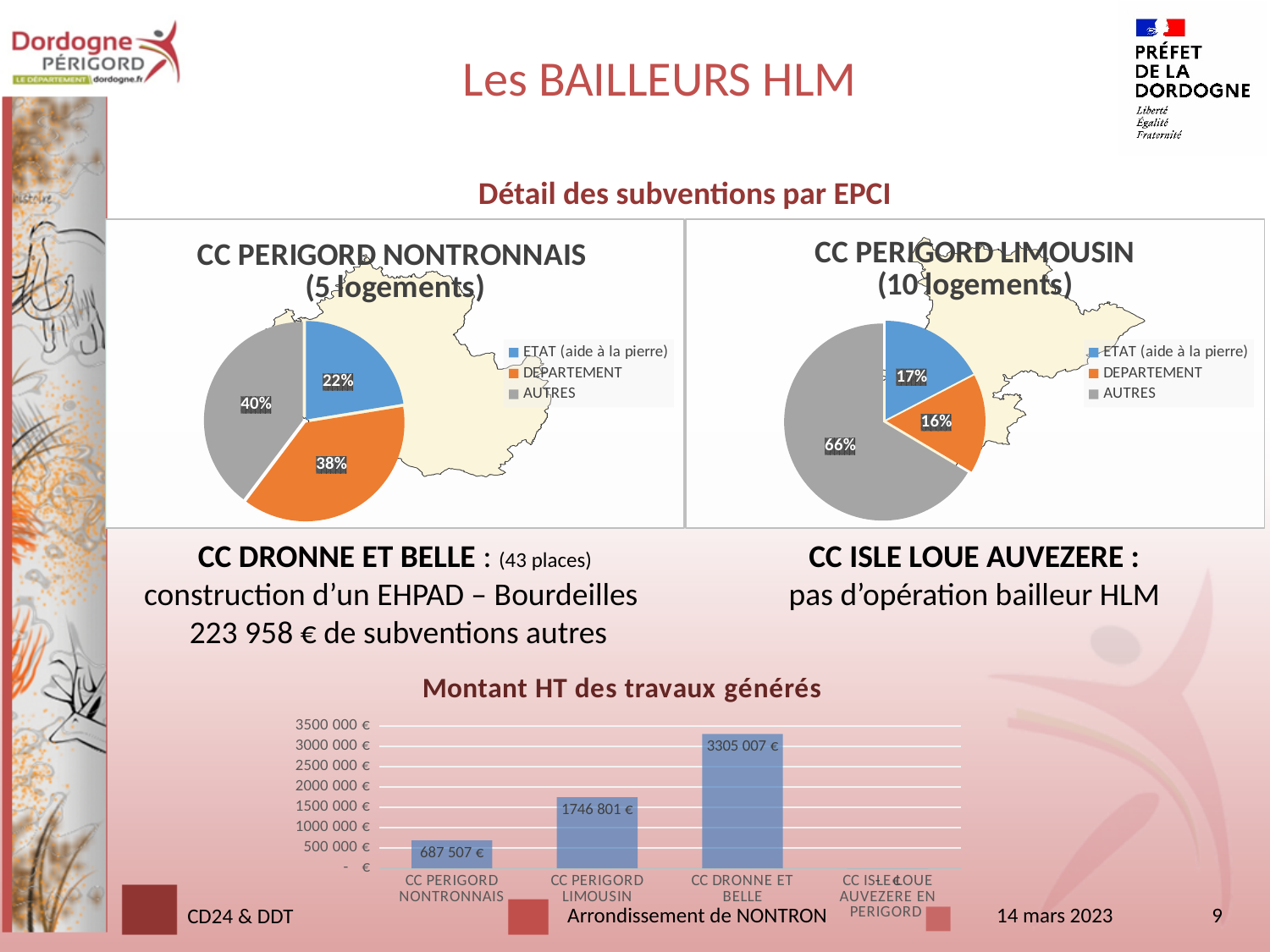
In the CC PERIGORD LIMOUSIN pie chart, what is the difference in percentage points between AUTRES and ETAT (aide à la pierre)? 49 percentage points In the CC PERIGORD LIMOUSIN pie chart, which slice is the smallest? DEPARTEMENT In the 'Montant HT des travaux générés' chart, what is the difference between CC PERIGORD LIMOUSIN and CC PERIGORD NONTRONNAIS? 1059 294 € In the CC PERIGORD NONTRONNAIS pie chart, which slice is the largest? AUTRES In the 'Montant HT des travaux générés' chart, what is the value for CC DRONNE ET BELLE? 3305 007 € In the CC PERIGORD NONTRONNAIS pie chart, what is the share for ETAT (aide à la pierre)? 22% In the 'Montant HT des travaux générés' chart, what is the value for CC PERIGORD NONTRONNAIS? 687 507 € In the 'Montant HT des travaux générés' chart, which category has the highest value? CC DRONNE ET BELLE How many entries does the legend of the CC PERIGORD LIMOUSIN pie chart list? 3 In the CC PERIGORD NONTRONNAIS pie chart, what share goes to DEPARTEMENT? 38% In the CC PERIGORD LIMOUSIN pie chart, what share goes to AUTRES? 66% What kind of chart is 'Montant HT des travaux générés'? Bar chart